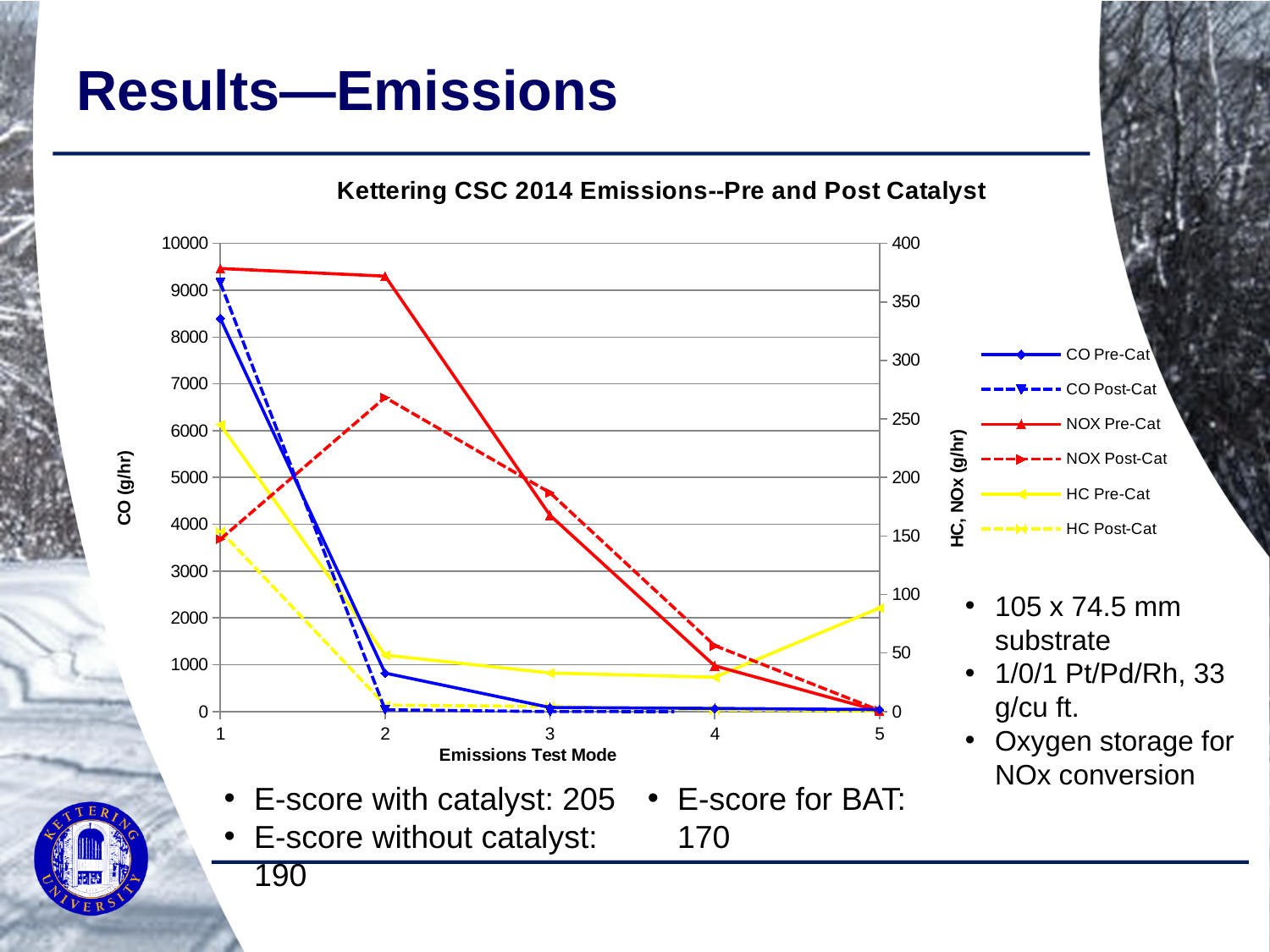
What kind of chart is shown on the slide? line chart How many series does the chart legend list? 6 Is the NOX Post-Cat value at test mode 2 greater or less than 250? greater Is the NOX Pre-Cat value at test mode 1 greater or less than 350? greater Is the CO Post-Cat value at test mode 2 greater or less than 1000? less At test mode 2, which is larger: NOX Pre-Cat or NOX Post-Cat? NOX Pre-Cat What is the title of the chart? Kettering CSC 2014 Emissions--Pre and Post Catalyst Does the CO Pre-Cat series rise or fall from test mode 1 to test mode 5? fall At which emissions test mode is NOX Post-Cat highest? 2 How many emissions test modes are plotted along the x axis? 5 What is the label of the left y axis? CO (g/hr)